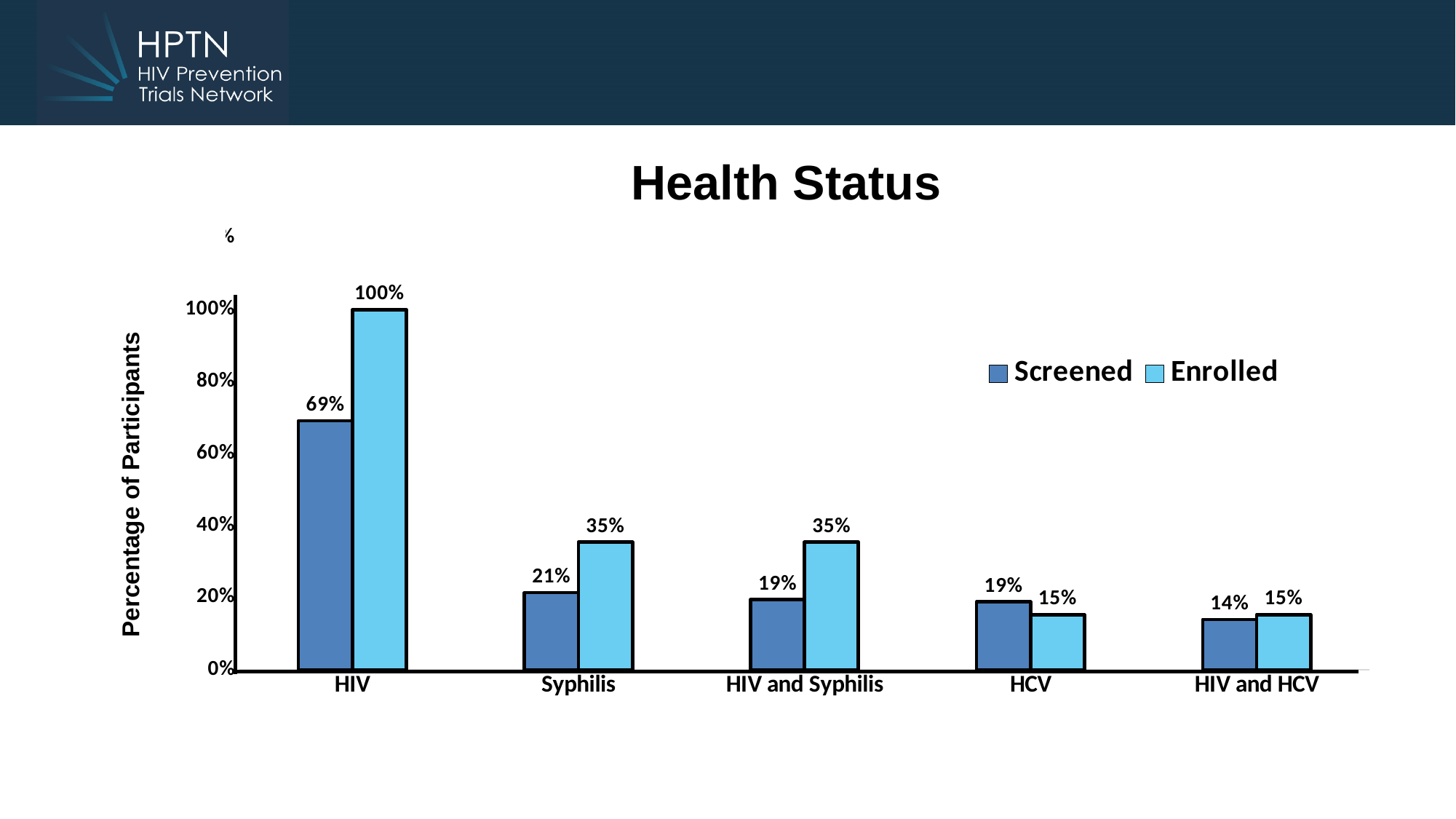
What is the difference between the Enrolled and Screened values for HIV? 31% How many categories are shown on the x axis? 5 How many series does the legend list? 2 Which category has the lowest Screened value? HIV and HCV What is the Screened value for Syphilis? 21% What kind of chart is shown on the slide? Bar chart Which is larger for HCV, the Screened value or the Enrolled value? Screened What is the Enrolled value for HCV? 15% What is the Screened value for HIV and HCV? 14% What is the difference between the Enrolled and Screened values for HIV and Syphilis? 16% Which category has the highest Screened value? HIV What is the Enrolled value for HIV? 100%